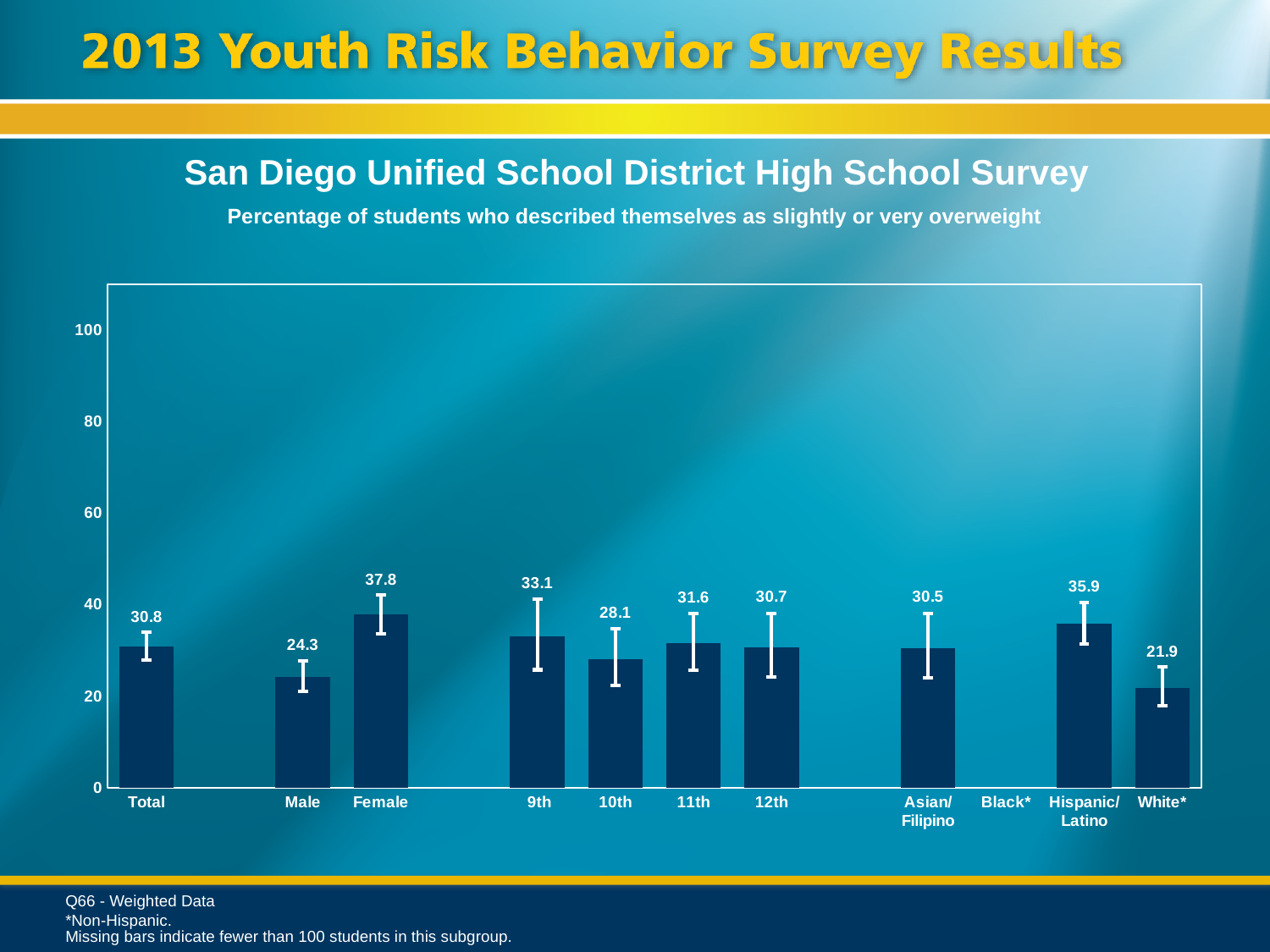
Which category has the lowest value among the plotted bars? White* What is the value for 10th grade? 28.1 What kind of chart is shown? bar chart What is the value for Hispanic/Latino? 35.9 Which is larger, the value for 9th or the value for 12th? 9th What is the difference between the Female and Male values? 13.5 What is the chart's subtitle describing the measured percentage? Percentage of students who described themselves as slightly or very overweight How many bars are plotted on the chart? 10 Which category has the highest value? Female What is the value for Female? 37.8 Is the value for Total greater or less than 40? less Which category label has no bar plotted? Black*